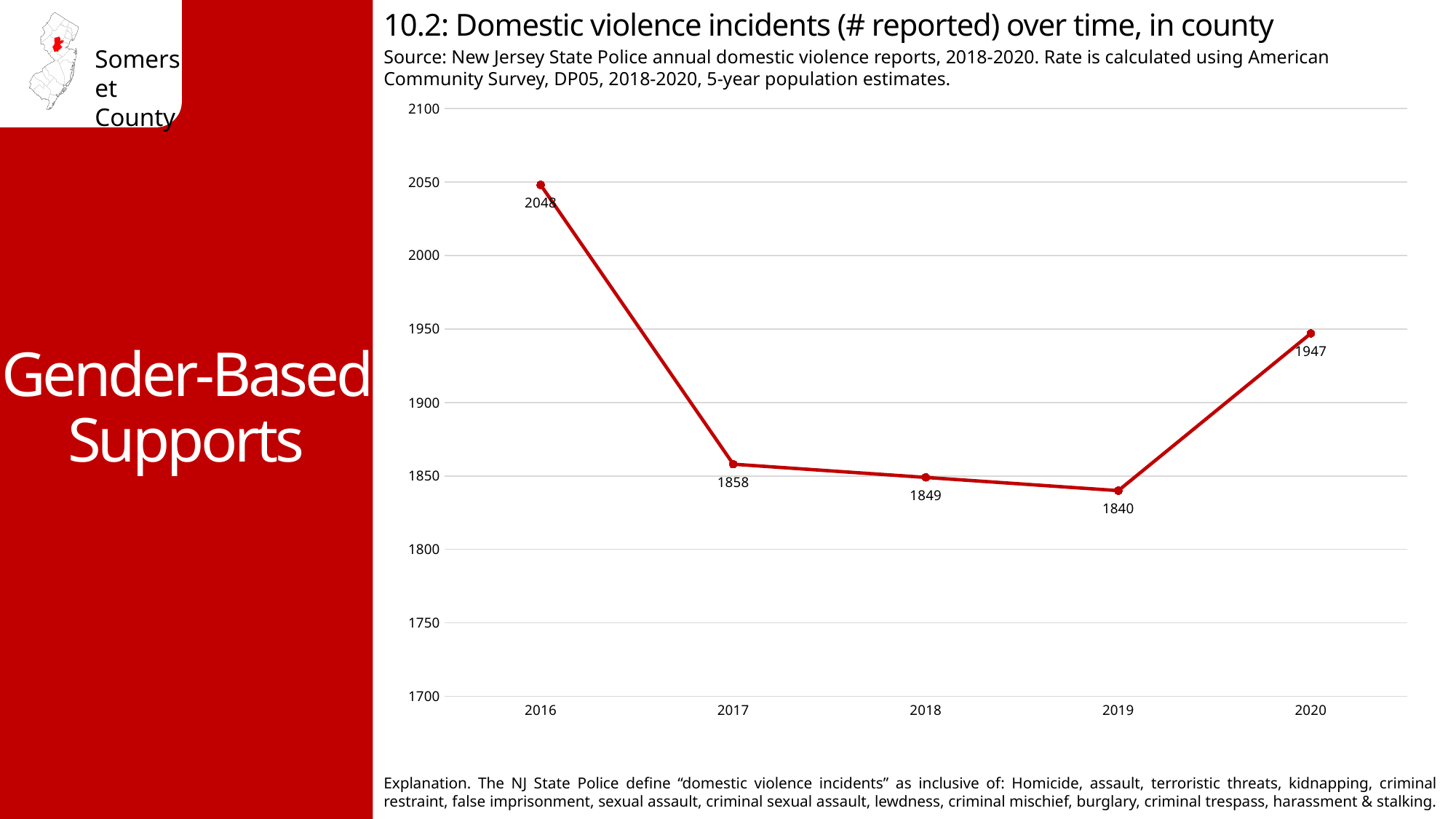
What was the number of reported domestic violence incidents in 2020? 1947 What kind of chart is shown on the slide? Line chart Which year had the lowest number of reported domestic violence incidents? 2019 Did the number of reported incidents rise or fall from 2016 to 2019? Fall How many years are plotted on the chart? 5 What is the difference in reported incidents between 2016 and 2017? 190 What was the number of reported domestic violence incidents in 2019? 1840 How many more incidents were reported in 2020 than in 2019? 107 Which year had the highest number of reported domestic violence incidents? 2016 What was the number of reported domestic violence incidents in 2016? 2048 Which year had more reported incidents, 2017 or 2018? 2017 Is the value for 2020 greater or less than 1900? greater